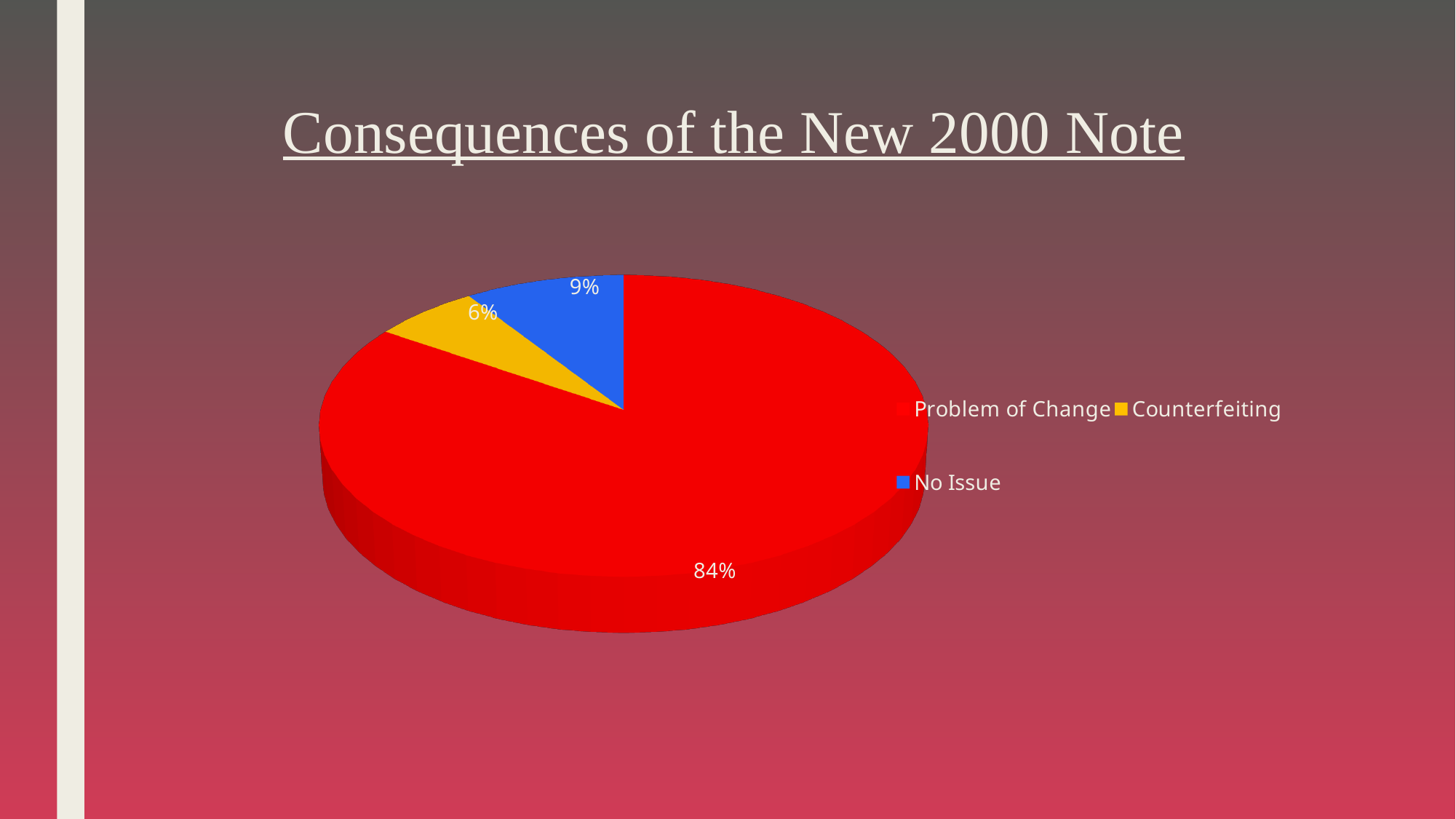
What is the difference in percentage points between the No Issue slice and the Counterfeiting slice? 3 What share of the pie does Problem of Change take? 84% What share of the pie does Counterfeiting take? 6% How many slices does the pie chart have? 3 What share of the pie does No Issue take? 9% What is the title of the slide containing the pie chart? Consequences of the New 2000 Note Which category has the largest slice of the pie? Problem of Change Which category has the smallest slice of the pie? Counterfeiting Which is larger, the slice for No Issue or the slice for Counterfeiting? No Issue What kind of chart is shown on the slide? pie chart What colour is the Counterfeiting slice in the pie chart? yellow What is the difference in percentage points between the Problem of Change slice and the No Issue slice? 75